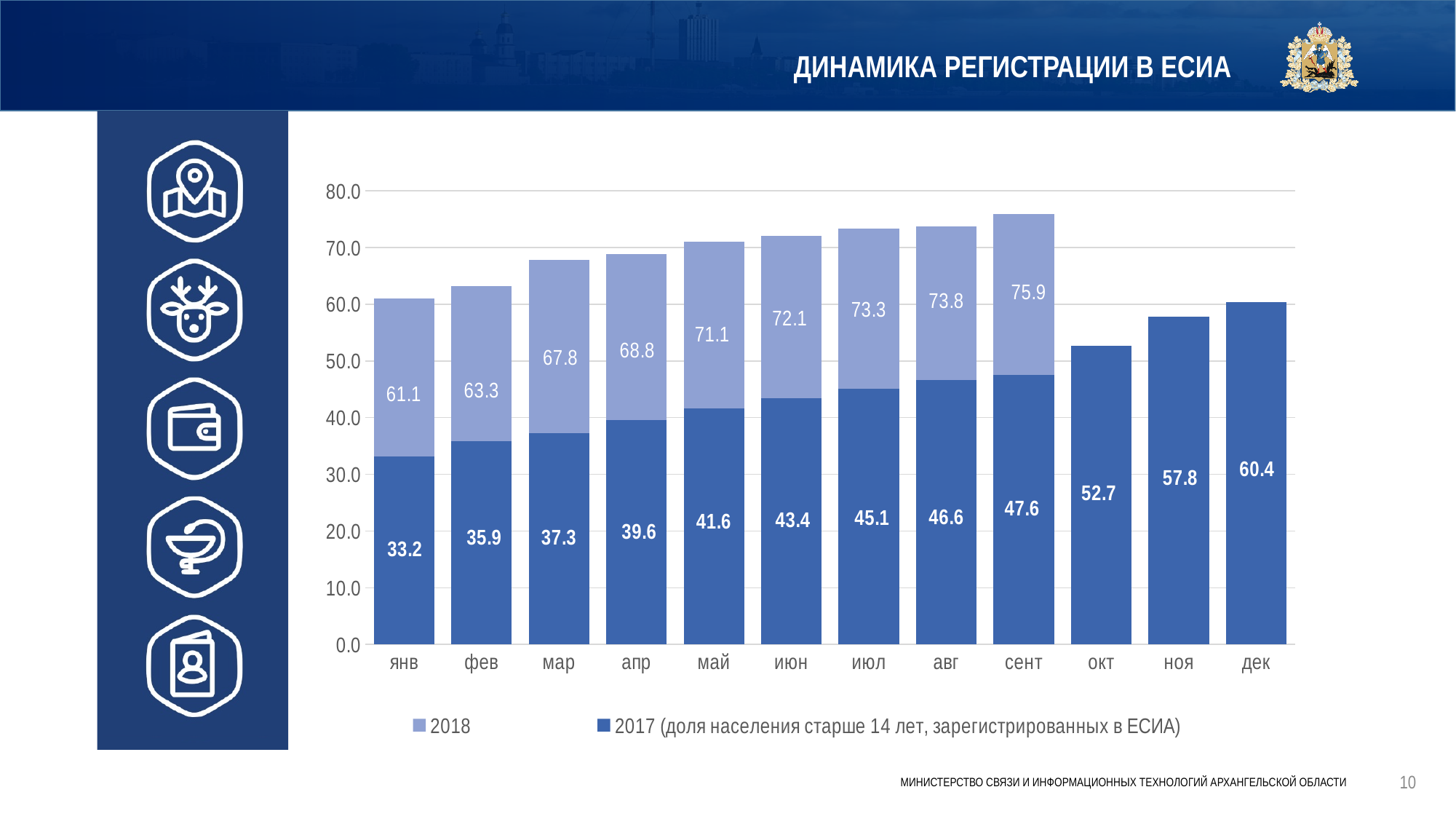
Which month has the lowest 2017 value? янв Which month has the highest 2018 value? сент What is the 2018 value for май? 71.1 Is the 2017 value for окт greater or less than 50.0? greater How many series does the legend list? 2 Which is larger: the 2018 value for фев or the 2017 value for дек? 2018 value for фев What is the difference between the 2017 values for дек and ноя? 2.6 How many months are shown on the x axis? 12 What is the 2017 value for дек? 60.4 Do the 2017 values rise or fall from янв to дек? rise What is the 2017 value for сент? 47.6 What is the difference between the 2018 and 2017 values for янв? 27.9